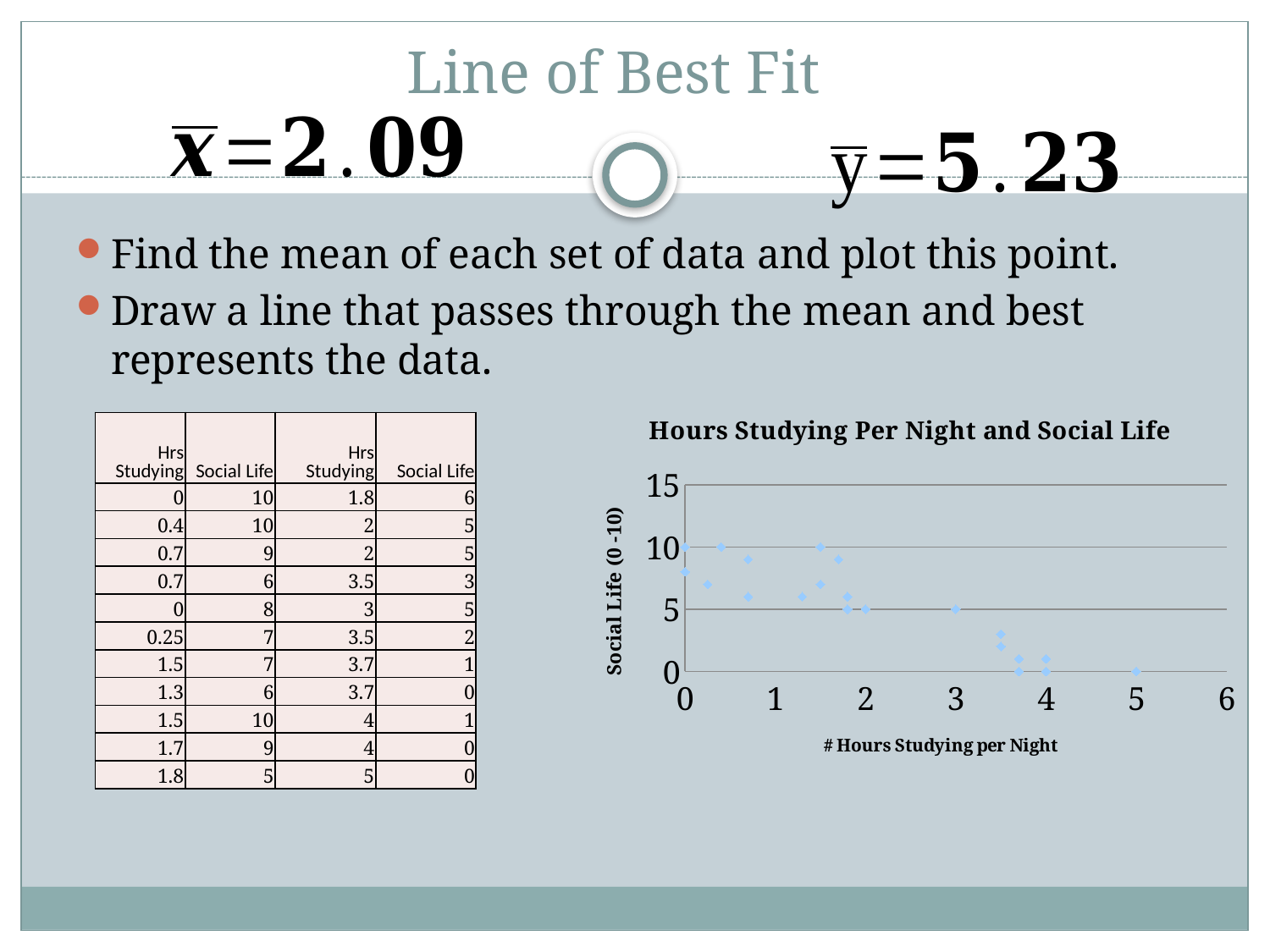
Is the Social Life value for the point at 0.4 hours studying greater or less than 5? greater What is the label of the chart's x axis? # Hours Studying per Night Is the Social Life value for the point at 3.5 hours studying greater or less than 5? less What is the Social Life value for the point at 5 hours studying per night? 0 What is the highest value shown on the chart's y axis? 15 What is the lowest Social Life value plotted on the chart? 0 What is the Social Life value for the point at 3 hours studying per night? 5 Which has the larger Social Life value: the point at 0.4 hours studying or the point at 4 hours studying? 0.4 hours studying What is the highest Social Life value plotted on the chart? 10 What kind of chart is shown on the slide? scatter chart What is the title of the chart? Hours Studying Per Night and Social Life As the number of hours studying per night increases, do the Social Life values generally rise or fall? fall